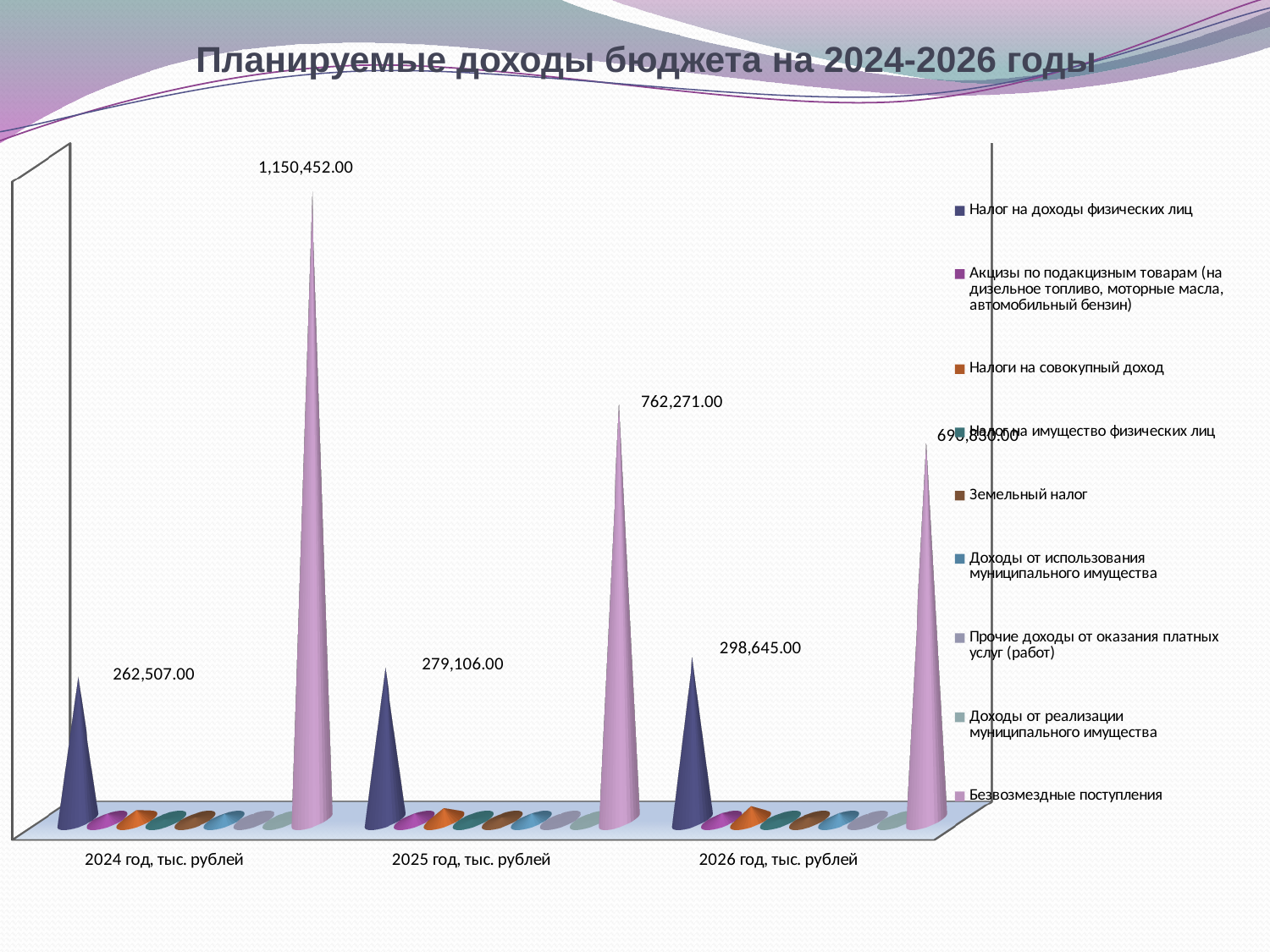
What is the difference between Налог на доходы физических лиц in 2026 and in 2024? 36,138.00 Does Налог на доходы физических лиц rise or fall from 2024 to 2026? rise What is the value of Безвозмездные поступления for 2024 год, тыс. рублей? 1,150,452.00 What is the value of Налог на доходы физических лиц for 2025 год, тыс. рублей? 279,106.00 What is the difference between Безвозмездные поступления in 2024 and in 2025? 388,181.00 What is the value of Налог на доходы физических лиц for 2026 год, тыс. рублей? 298,645.00 In which year is Безвозмездные поступления highest? 2024 год, тыс. рублей Which is larger: Налог на доходы физических лиц in 2025 or in 2026? 2026 How many series does the legend list? 9 What is the value of Налог на доходы физических лиц for 2024 год, тыс. рублей? 262,507.00 How many year categories are shown on the x axis? 3 What is the value of Безвозмездные поступления for 2025 год, тыс. рублей? 762,271.00